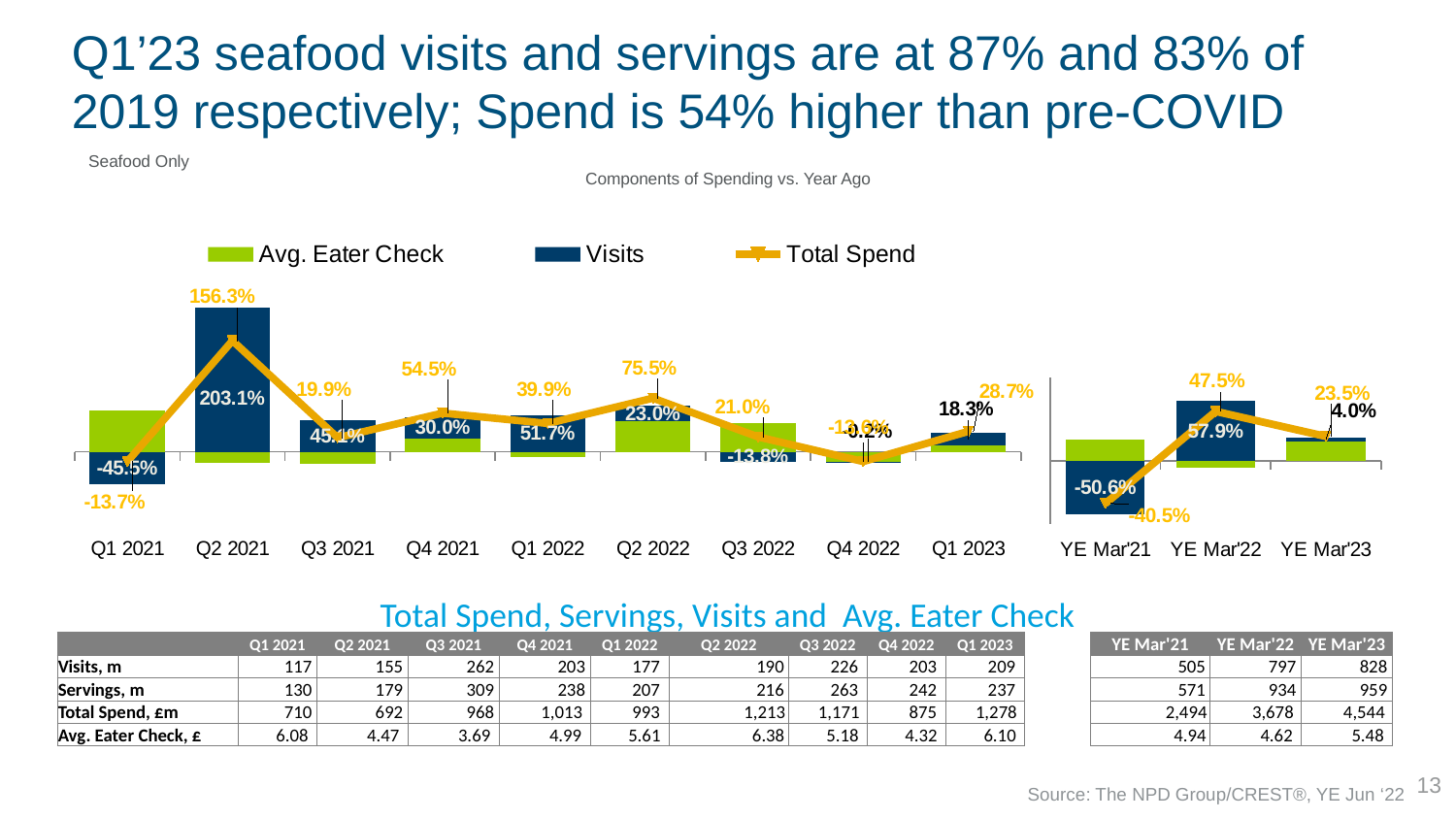
How many quarters are shown on the x axis of the quarterly 'Components of Spending vs. Year Ago' chart? 9 In the year-ending 'Components of Spending vs. Year Ago' chart on the right, what is the Total Spend value for YE Mar'23? 23.5% What kind of chart is used for 'Components of Spending vs. Year Ago'? A bar chart combined with a line In the year-ending 'Components of Spending vs. Year Ago' chart on the right, what is the Visits value for YE Mar'21? -50.6% In the quarterly 'Components of Spending vs. Year Ago' chart, what is the difference between the Total Spend value (28.7%) and the Visits value (18.3%) for Q1 2023? 10.4 percentage points In the quarterly 'Components of Spending vs. Year Ago' chart, which quarter has the highest Total Spend value? Q2 2021 In the quarterly 'Components of Spending vs. Year Ago' chart, which quarter has the lowest Visits value? Q1 2021 How many series does the legend of the 'Components of Spending vs. Year Ago' chart list? 3 In the quarterly 'Components of Spending vs. Year Ago' chart, what is the Visits value for Q2 2021? 203.1% In the quarterly 'Components of Spending vs. Year Ago' chart, what is the Total Spend value for Q2 2022? 75.5% In the quarterly 'Components of Spending vs. Year Ago' chart, which is larger for Q1 2023: Total Spend or Visits? Total Spend In the quarterly 'Components of Spending vs. Year Ago' chart, what is the Total Spend value for Q1 2021? -13.7%